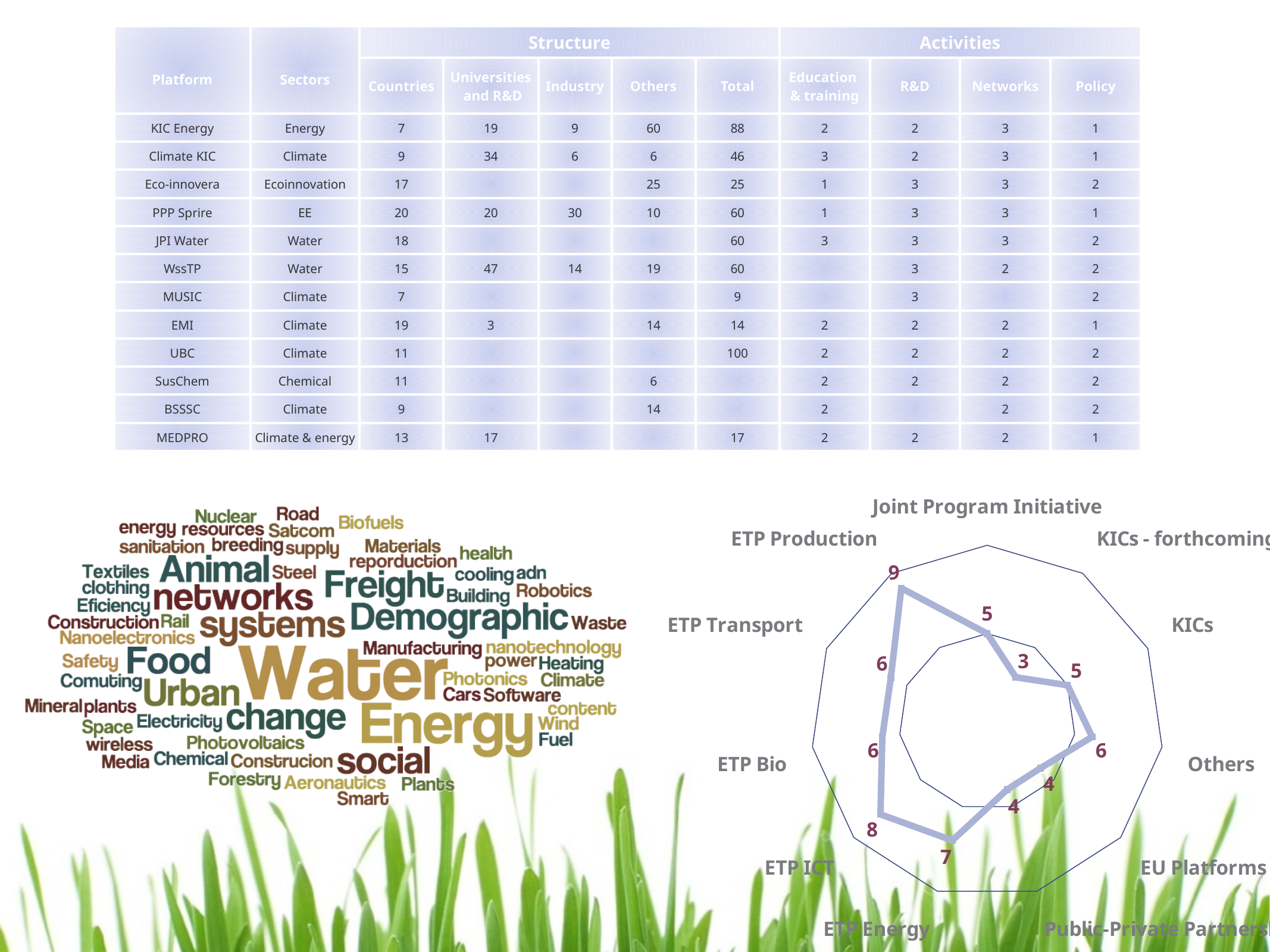
In the radar chart, which is larger, the value for ETP ICT or the value for KICs? ETP ICT In the radar chart, what is the value for Others? 6 In the radar chart, which category has the highest value? ETP Production In the radar chart, what is the value for ETP Energy? 7 What kind of chart is shown at the bottom right of the slide? radar chart In the radar chart, what is the value for ETP Production? 9 In the radar chart, what is the value for KICs - forthcoming? 3 In the radar chart, what is the difference between the values for ETP Production and ETP Energy? 2 How many categories (axes) does the radar chart have? 11 In the radar chart, which category has the lowest value? KICs - forthcoming In the radar chart, what is the value for Joint Program Initiative? 5 In the radar chart, what is the value for ETP ICT? 8